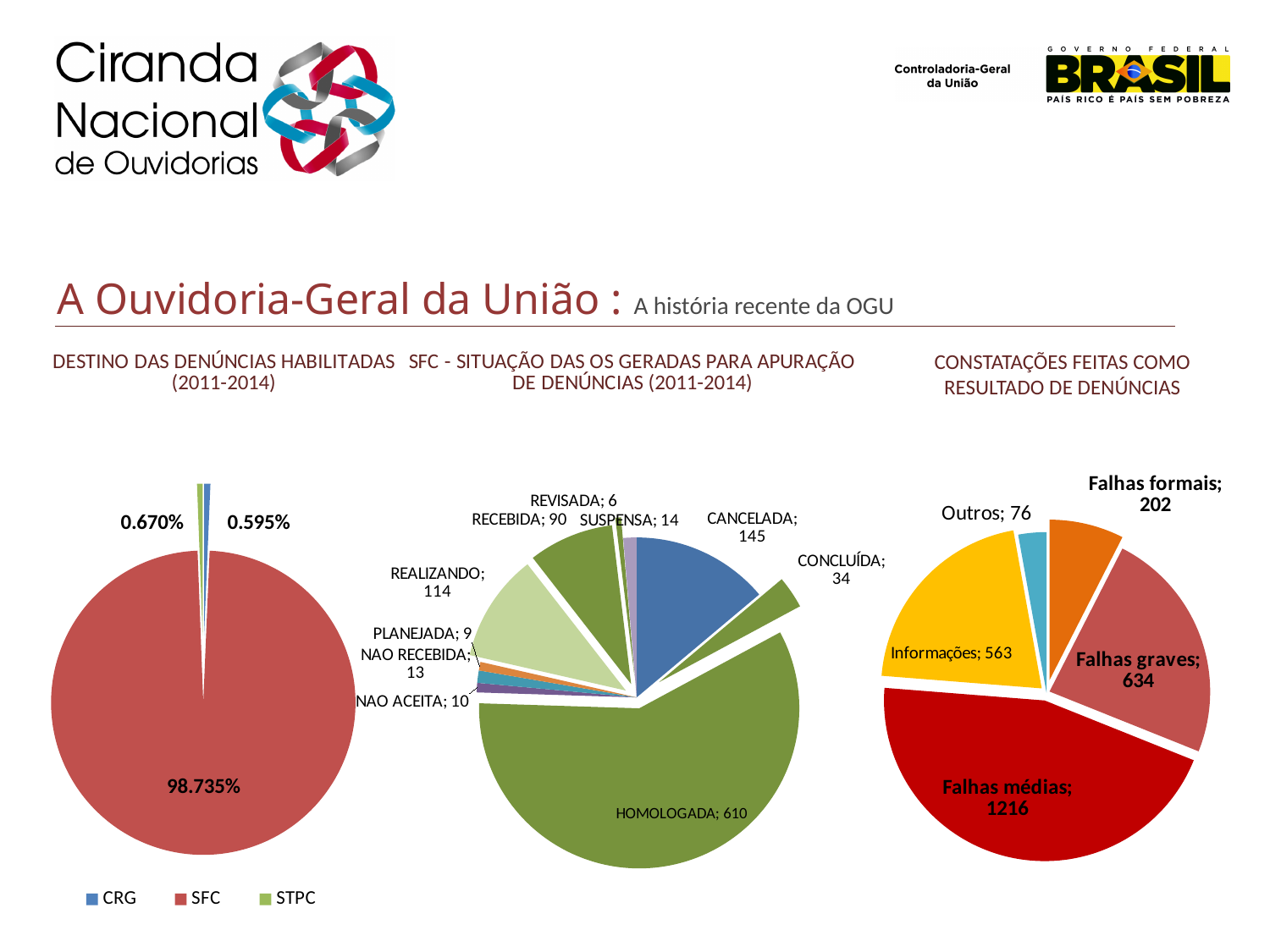
In the middle chart ('SFC - SITUAÇÃO DAS OS GERADAS...'), which category has the smallest value? REVISADA In the middle chart ('SFC - SITUAÇÃO DAS OS GERADAS...'), what is the value for HOMOLOGADA? 610 In the chart titled 'DESTINO DAS DENÚNCIAS HABILITADAS (2011-2014)', what share is shown for SFC? 98.735% What kind of chart is the middle chart ('SFC - SITUAÇÃO DAS OS GERADAS PARA APURAÇÃO DE DENÚNCIAS')? Pie chart In the chart titled 'DESTINO DAS DENÚNCIAS HABILITADAS (2011-2014)', which category has the largest share? SFC In the right chart ('CONSTATAÇÕES FEITAS COMO RESULTADO DE DENÚNCIAS'), what is the difference between Falhas médias and Falhas graves? 582 In the right chart ('CONSTATAÇÕES FEITAS COMO RESULTADO DE DENÚNCIAS'), what is the value for Falhas graves? 634 How many series does the legend of the left chart ('DESTINO DAS DENÚNCIAS HABILITADAS') list? 3 In the middle chart ('SFC - SITUAÇÃO DAS OS GERADAS...'), how many categories are shown? 10 In the middle chart ('SFC - SITUAÇÃO DAS OS GERADAS...'), what is the value for CANCELADA? 145 In the middle chart ('SFC - SITUAÇÃO DAS OS GERADAS...'), what is the difference between REALIZANDO and RECEBIDA? 24 In the right chart ('CONSTATAÇÕES FEITAS COMO RESULTADO DE DENÚNCIAS'), which is larger, Informações or Falhas formais? Informações